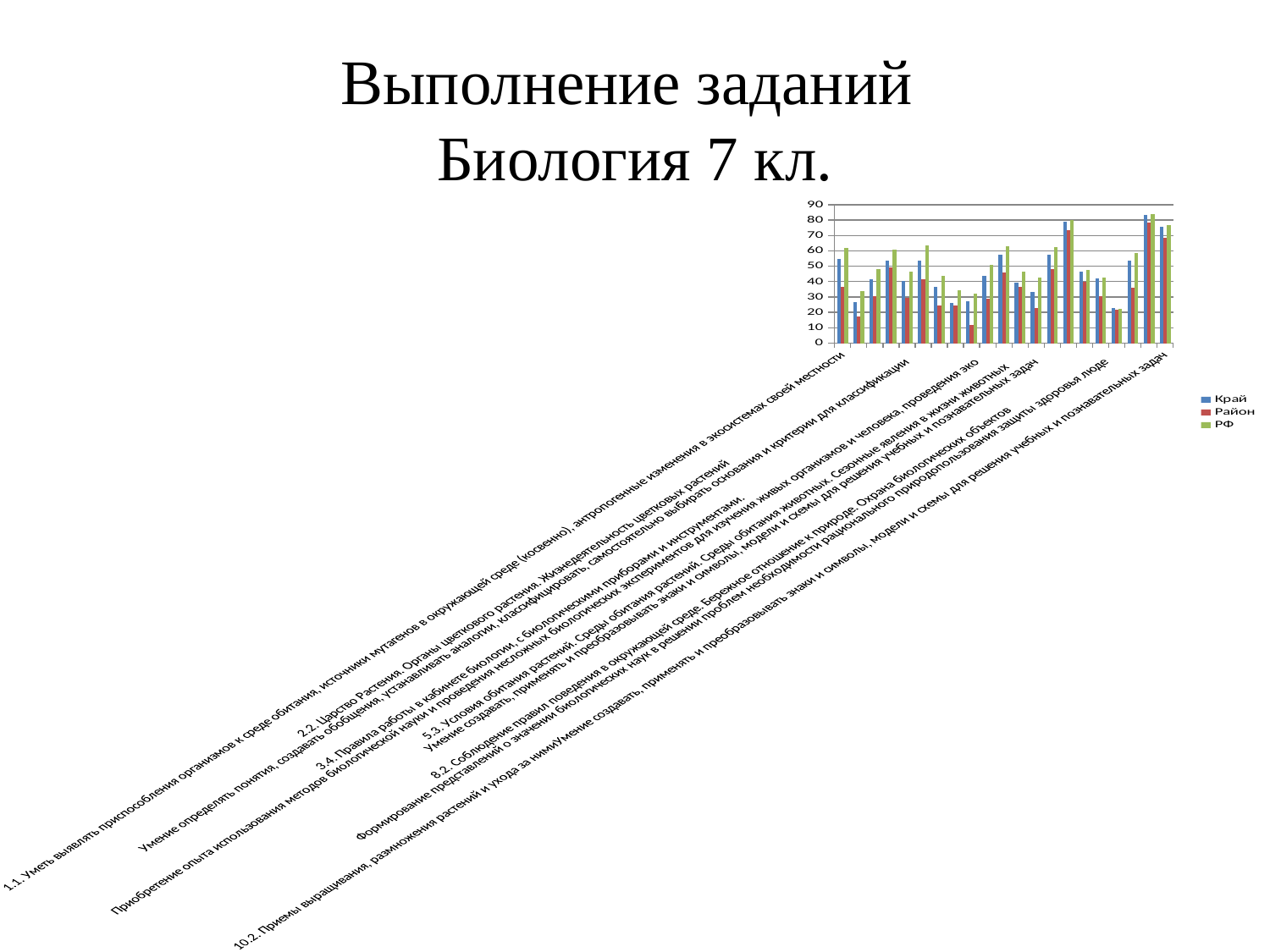
Is the value for Район in the rightmost category group greater or less than 60? greater How many series does the legend list? 3 What is the title of the slide containing the chart? Выполнение заданий Биология 7 кл. In the first (leftmost) category group, which series has the highest bar? РФ Is the value for Район in the second category group greater or less than 30? less Is the value for Край in the rightmost category group greater or less than 70? greater What are the three series named in the legend? Край, Район, РФ In the first (leftmost) category group, which series has the lowest bar? Район What kind of chart is shown on the slide? bar chart